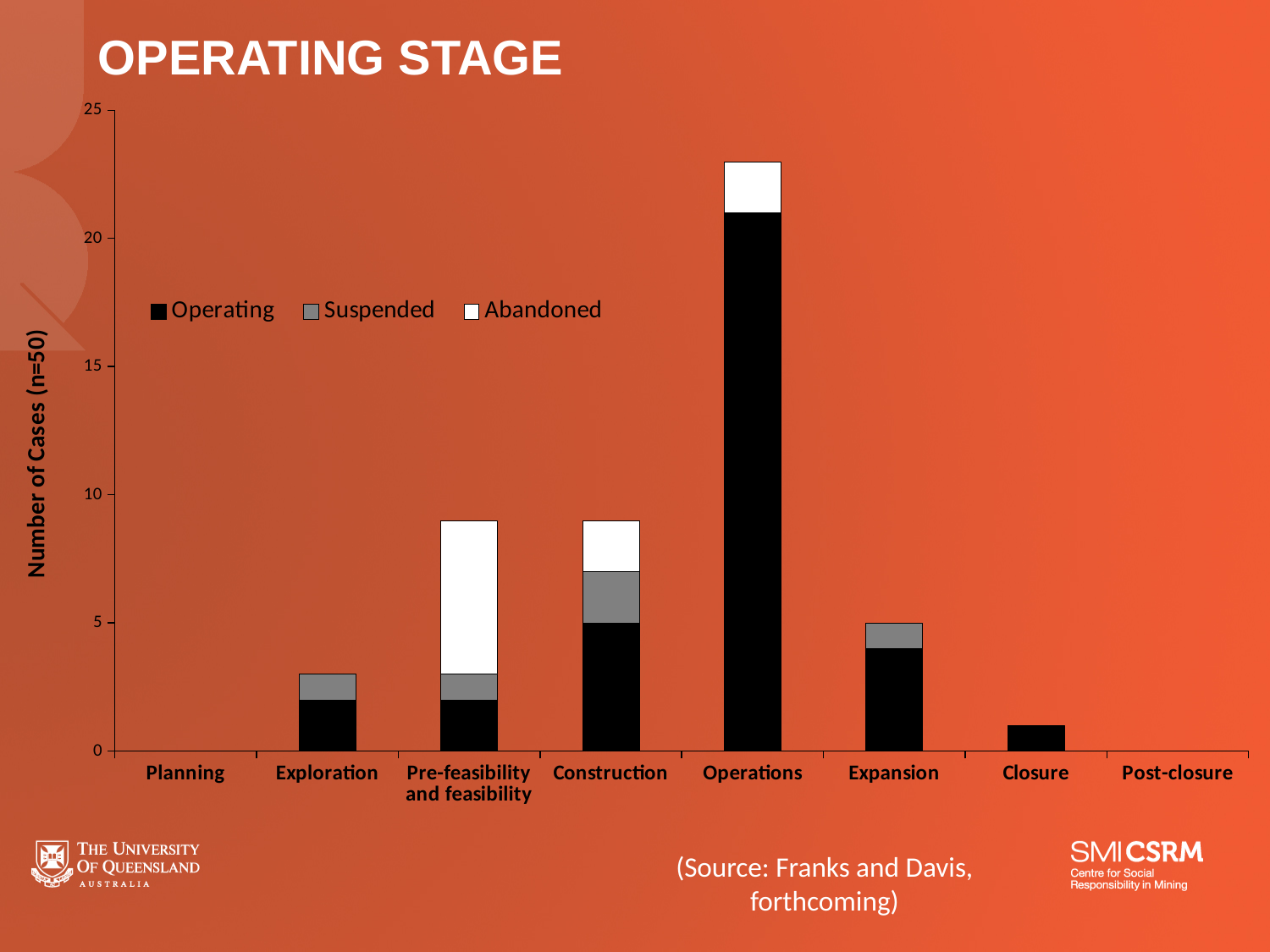
Is the total number of cases for Operations greater or less than 20? greater Which series is shown in white in the legend? Abandoned Is the total number of cases for Construction greater or less than 10? less Is the total number of cases for Closure greater or less than 5? less What is the label on the y axis? Number of Cases (n=50) Which operating stage has the largest Abandoned segment? Pre-feasibility and feasibility How many operating-stage categories are shown along the x axis? 8 Which has more total cases, Construction or Exploration? Construction How many series does the legend list? 3 What kind of chart is shown on the slide? Stacked bar chart Which operating stage has the highest total number of cases? Operations